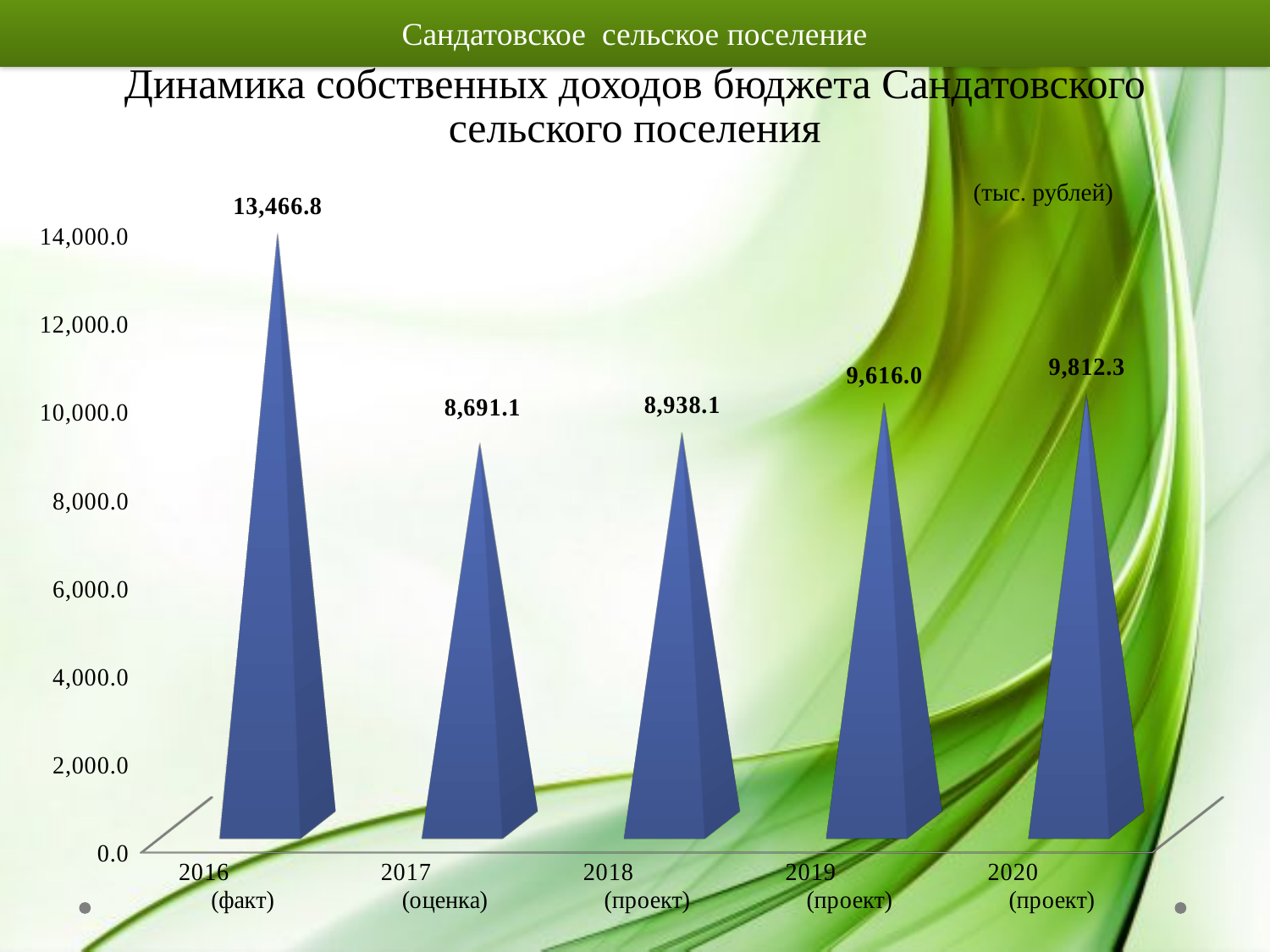
Which year has the lowest value? 2017 (оценка) Do the values rise or fall from 2017 (оценка) to 2020 (проект)? rise How many years are shown on the x axis? 5 What is the value for 2020 (проект)? 9,812.3 What is the difference between the values for 2020 (проект) and 2019 (проект)? 196.3 What is the value for 2016 (факт)? 13,466.8 What is the difference between the values for 2016 (факт) and 2017 (оценка)? 4,775.7 Which year has the highest value? 2016 (факт) What kind of chart is shown on the slide? bar chart Is the value for 2017 (оценка) greater or less than 10,000.0? less Which is larger, the value for 2018 (проект) or the value for 2019 (проект)? 2019 (проект) What is the value for 2018 (проект)? 8,938.1